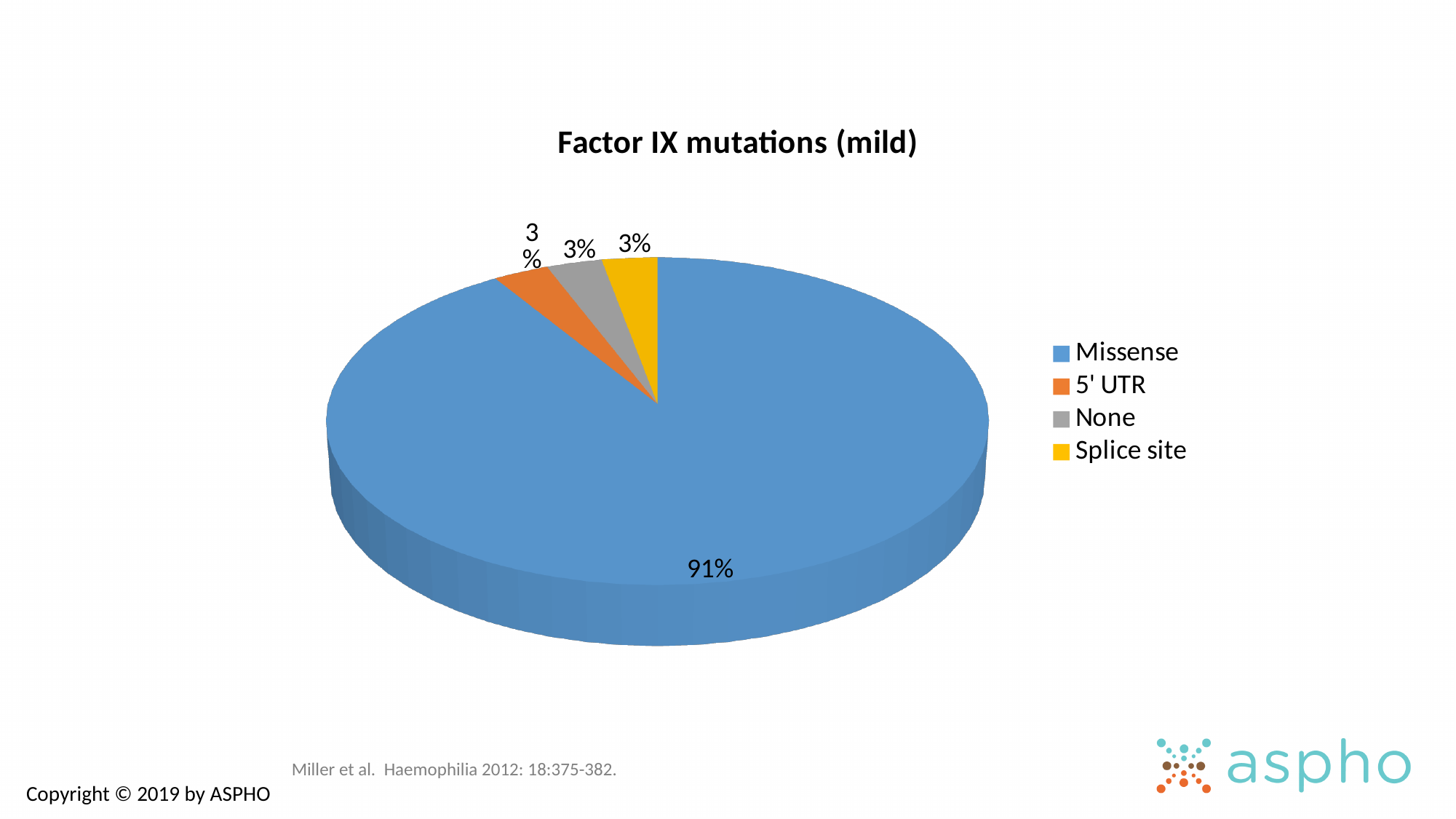
What share of the pie does Splice site account for? 3% Which category has the largest slice of the pie? Missense What colour is the Missense slice? blue What share of the pie does Missense account for? 91% How many categories does the legend list? 4 What is the title of the chart? Factor IX mutations (mild) Which is larger, the Missense slice or the None slice? Missense What is the combined share of 5' UTR, None and Splice site? 9% What is the difference between the Missense share and the Splice site share? 88% What share of the pie does None account for? 3% What kind of chart is shown on the slide? pie chart